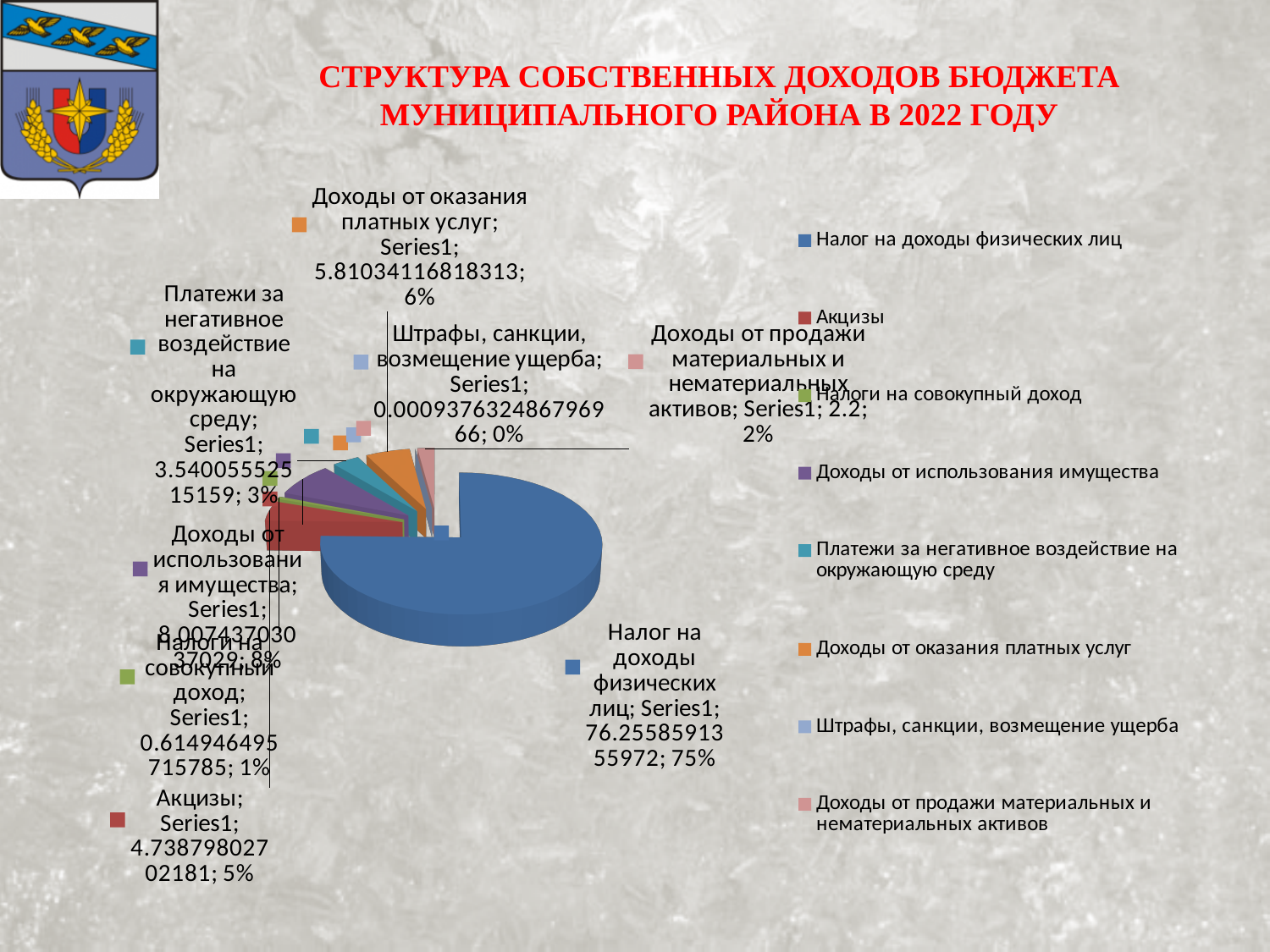
How many categories does the pie chart have? 8 What is the title of the slide containing the chart? СТРУКТУРА СОБСТВЕННЫХ ДОХОДОВ БЮДЖЕТА МУНИЦИПАЛЬНОГО РАЙОНА В 2022 ГОДУ Which category has the smallest slice of the pie? Штрафы, санкции, возмещение ущерба What share of the pie does "Налог на доходы физических лиц" represent? 75% What share of the pie does "Доходы от использования имущества" represent? 8% Which is larger: the share for "Акцизы" or the share for "Доходы от использования имущества"? Доходы от использования имущества What share of the pie does "Платежи за негативное воздействие на окружающую среду" represent? 3% Which category has the largest slice of the pie? Налог на доходы физических лиц What kind of chart is shown on the slide? pie chart